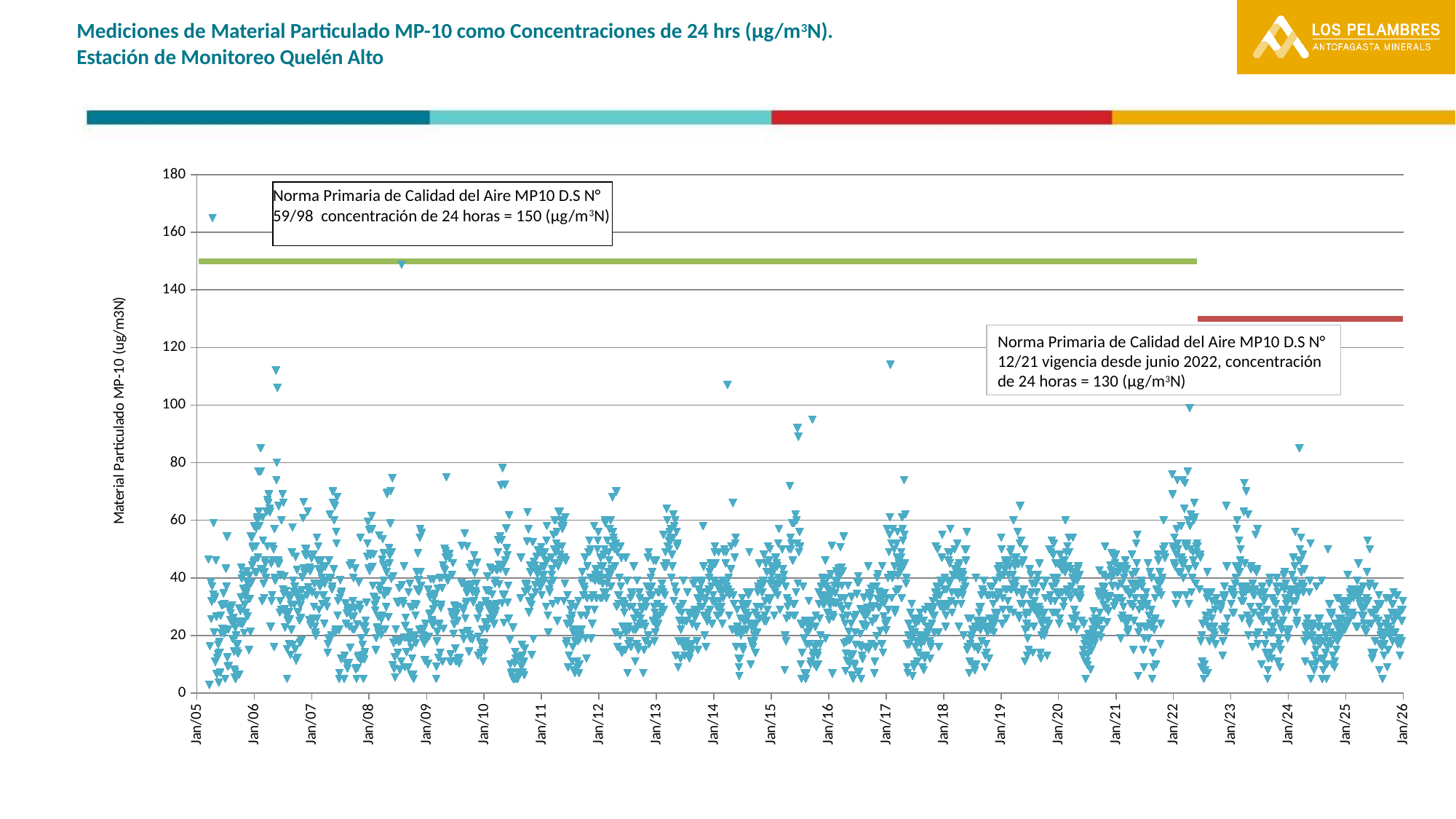
What kind of chart is shown on the slide? scatter chart From when is the D.S N° 12/21 standard in force, according to the annotation? junio 2022 Which is larger, the spike just after Jan/05 or the spike just after Jan/17? the spike just after Jan/05 Is the spike just after Jan/24 greater or less than 100? less What 24-hour concentration limit does the Norma Primaria de Calidad del Aire MP10 D.S N° 59/98 set, according to the annotation? 150 (µg/m³N) Which standard sets the higher 24-hour limit, D.S N° 59/98 or D.S N° 12/21? D.S N° 59/98 What 24-hour concentration limit does the Norma Primaria de Calidad del Aire MP10 D.S N° 12/21 set, according to the annotation? 130 (µg/m³N) What is the title of the chart on the slide? Mediciones de Material Particulado MP-10 como Concentraciones de 24 hrs (µg/m³N). Estación de Monitoreo Quelén Alto By how much does the D.S N° 59/98 limit (150) exceed the D.S N° 12/21 limit (130)? 20 Is the spike just after Jan/17 greater or less than 100? greater Is the highest plotted value, the point just after Jan/05, greater or less than 160? greater